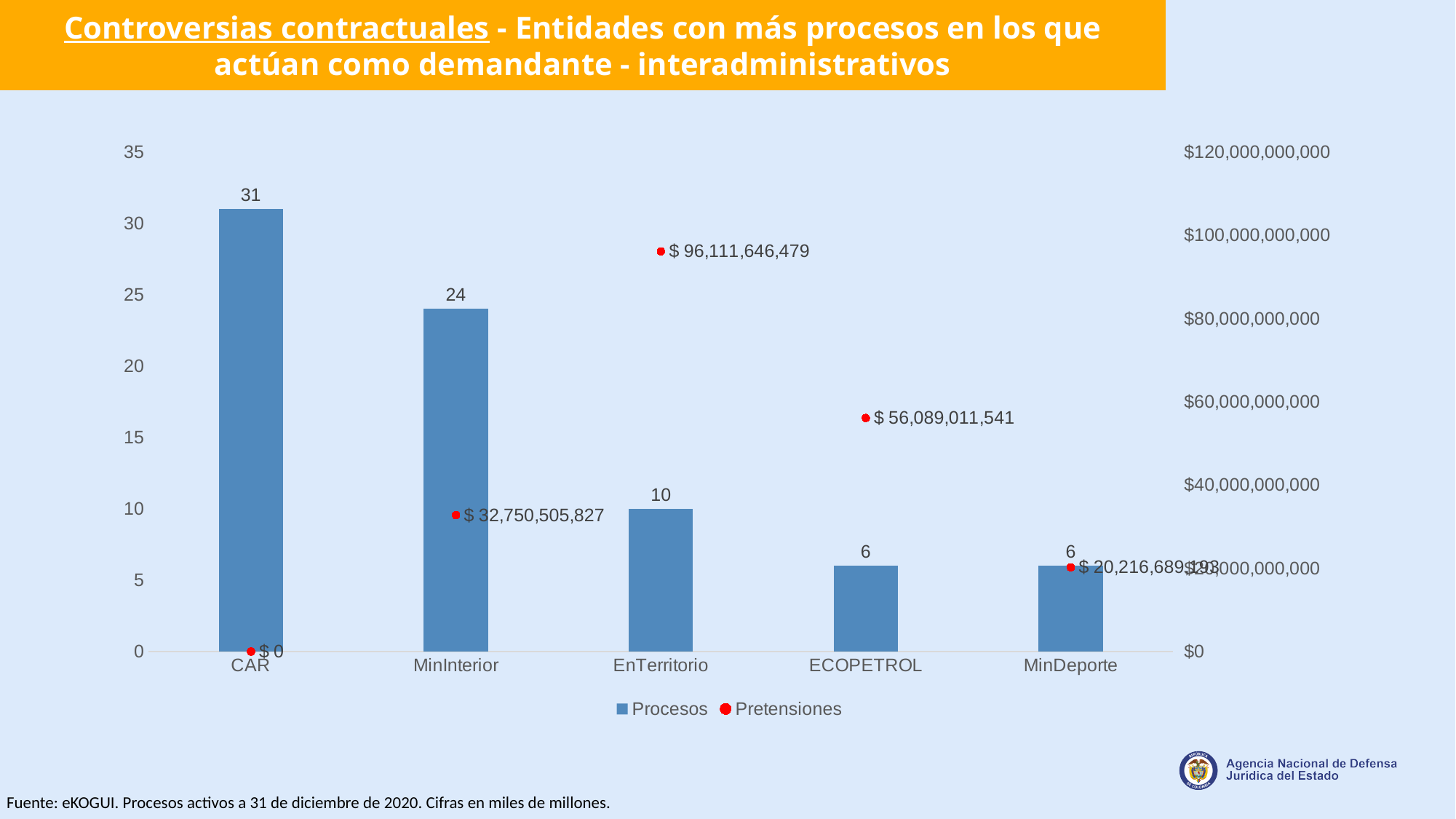
What is the Pretensiones value for EnTerritorio? $ 96,111,646,479 How many Procesos are shown for CAR? 31 What is the Pretensiones value for CAR? $ 0 How many series does the legend list? 2 What is the difference in Procesos between CAR and MinInterior? 7 What is the Pretensiones value for ECOPETROL? $ 56,089,011,541 How many entities are shown on the x axis? 5 Which has more Procesos, EnTerritorio or ECOPETROL? EnTerritorio What is the Procesos value for MinInterior? 24 Which entity has the highest number of Procesos? CAR Which entity has the highest Pretensiones value? EnTerritorio Do the Procesos values rise or fall from left to right along the x axis? fall